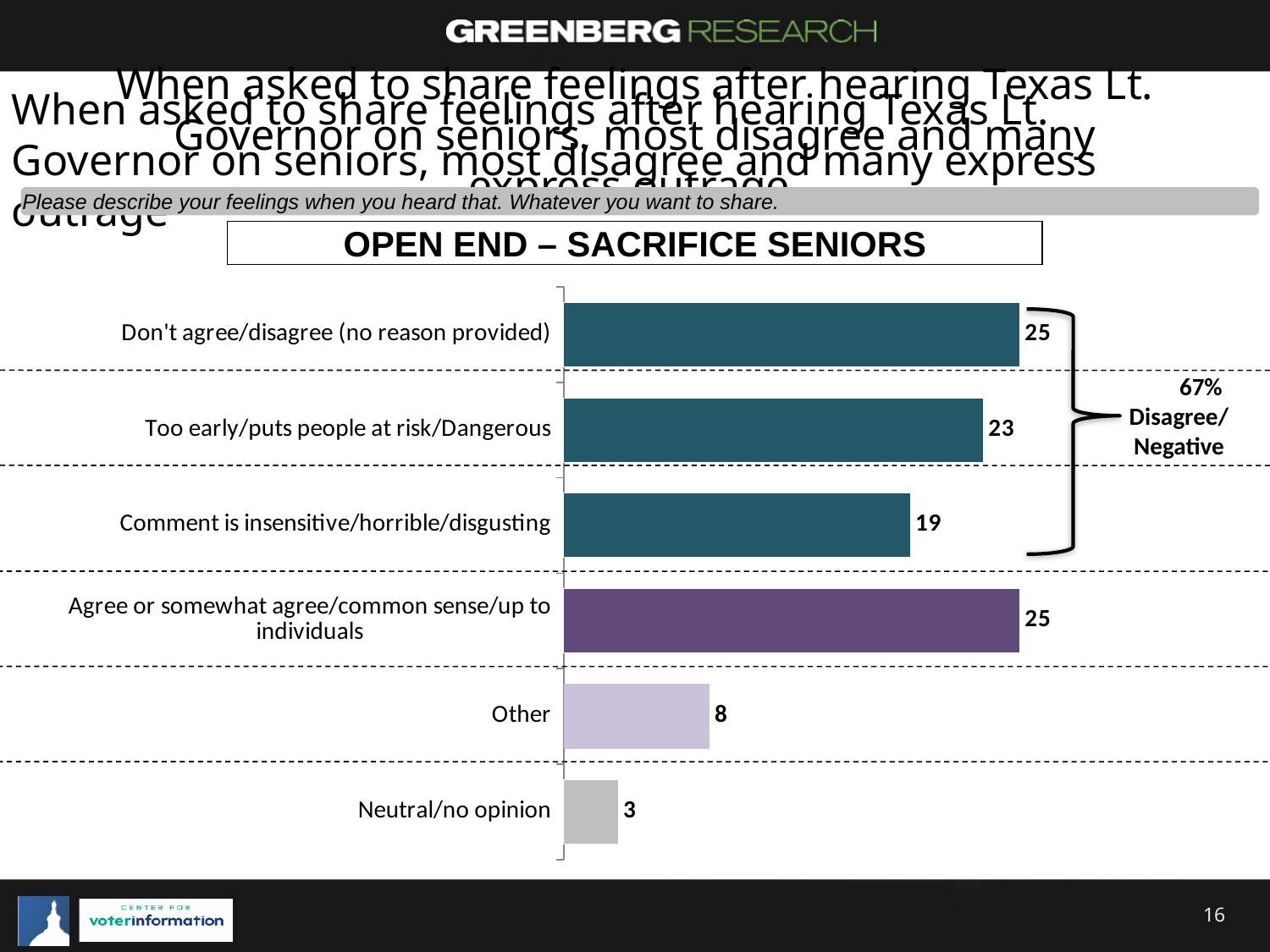
What is the value for "Too early/puts people at risk/Dangerous"? 23 What is the combined value of the three categories grouped under the "Disagree/Negative" bracket? 67% What is the difference between the values for "Other" and "Neutral/no opinion"? 5 What is the difference between the values for "Too early/puts people at risk/Dangerous" and "Comment is insensitive/horrible/disgusting"? 4 Which is larger, the value for "Too early/puts people at risk/Dangerous" or for "Comment is insensitive/horrible/disgusting"? Too early/puts people at risk/Dangerous How many categories are shown in the chart? 6 Which category has the lowest value? Neutral/no opinion What is the value for "Other"? 8 What is the value for "Comment is insensitive/horrible/disgusting"? 19 What is the value for "Agree or somewhat agree/common sense/up to individuals"? 25 What is the title shown in the box above the chart? OPEN END – SACRIFICE SENIORS What kind of chart is shown on the slide? Bar chart